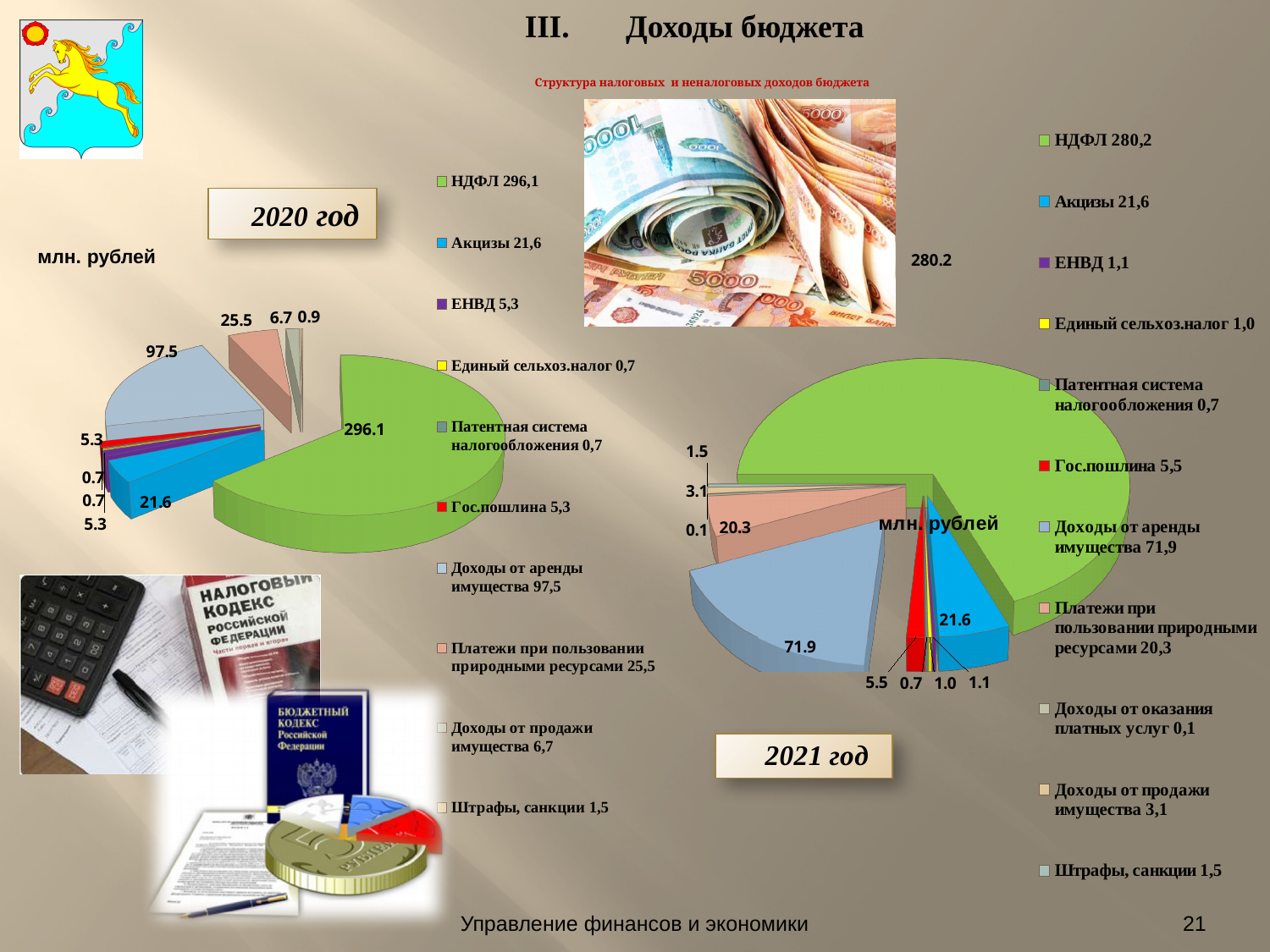
In the 2020 год chart, what is the value for Акцизы? 21.6 How much larger is НДФЛ in the 2020 год chart than in the 2021 год chart? 15.9 In the 2020 год chart, which is larger: Доходы от аренды имущества or Платежи при пользовании природными ресурсами? Доходы от аренды имущества In the 2021 год chart, what is the value for Платежи при пользовании природными ресурсами? 20.3 How many categories does the legend of the 2021 год chart list? 11 In the 2021 год chart, what is the value for Доходы от аренды имущества? 71.9 What type of chart is used for the 2020 год data? pie chart In the 2020 год chart, what is the value for НДФЛ? 296.1 In the 2021 год chart, what is the difference between Доходы от аренды имущества and Платежи при пользовании природными ресурсами? 51.6 In the 2021 год chart, which category has the largest value? НДФЛ What unit is stated for the values in both charts? млн. рублей In the 2021 год chart, which category has the smallest value? Доходы от оказания платных услуг